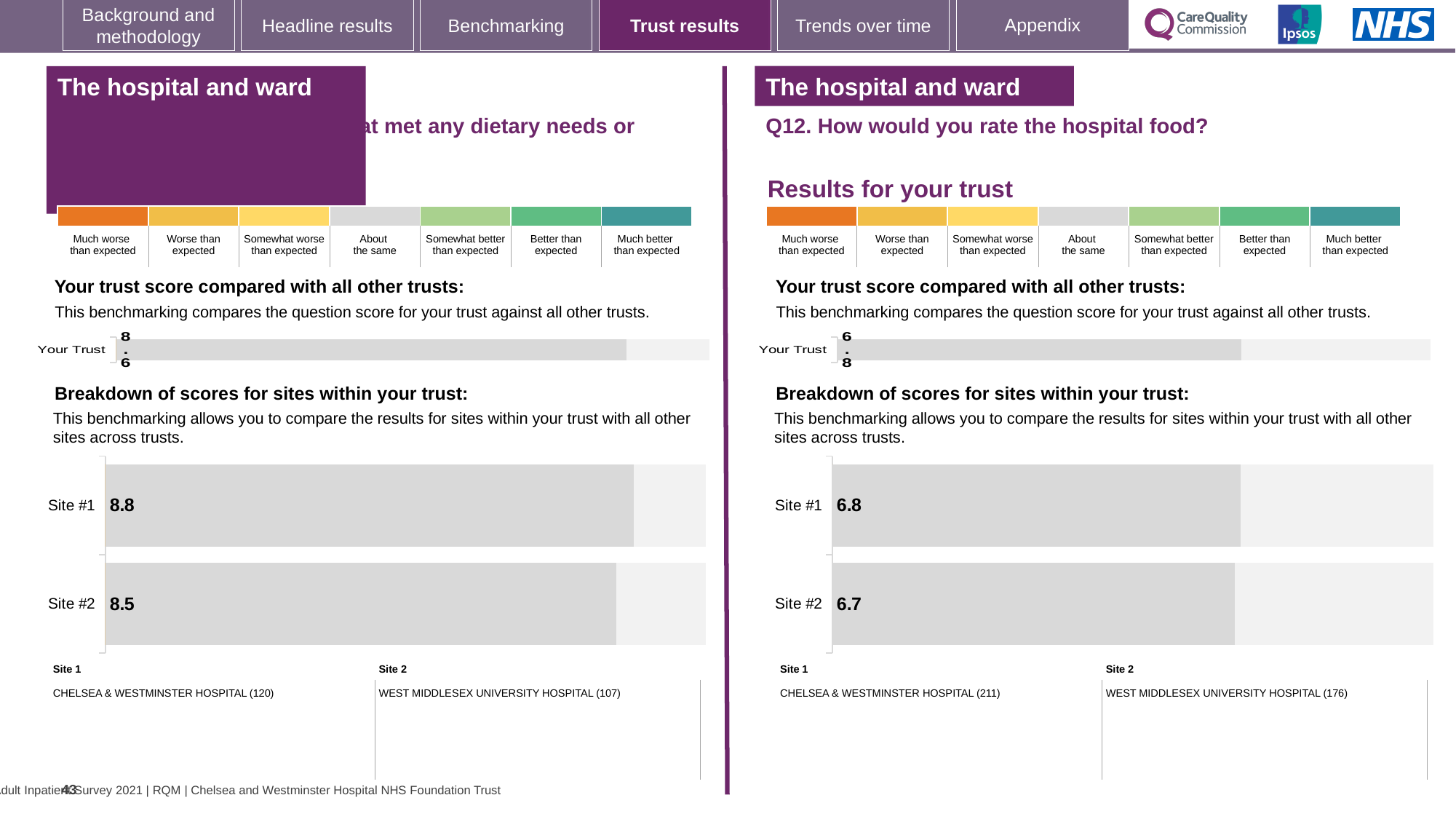
On the left-hand site breakdown chart, what is the score for Site #2? 8.5 On the right-hand 'Your trust score compared with all other trusts' chart for Q12, what is the score for Your Trust? 6.8 On the right-hand site breakdown chart for Q12, which site has the lower score? Site #2 What type of chart is used for the site breakdown on the left-hand side of the slide? Bar chart On the right-hand chart for Q12 (hospital food), what is the score for Site #2? 6.7 On the right-hand site breakdown chart for Q12, what is the difference between the Site #1 and Site #2 scores? 0.1 On the left-hand site breakdown chart, which site has the higher score? Site #1 On the left-hand 'Your trust score compared with all other trusts' chart, what is the score for Your Trust? 8.6 On the left-hand site breakdown chart, what is the score for Site #1? 8.8 How many sites are shown on the right-hand site breakdown chart for Q12? 2 On the left-hand site breakdown chart, what is the difference between the Site #1 and Site #2 scores? 0.3 On the right-hand chart for Q12 (hospital food), what is the score for Site #1? 6.8